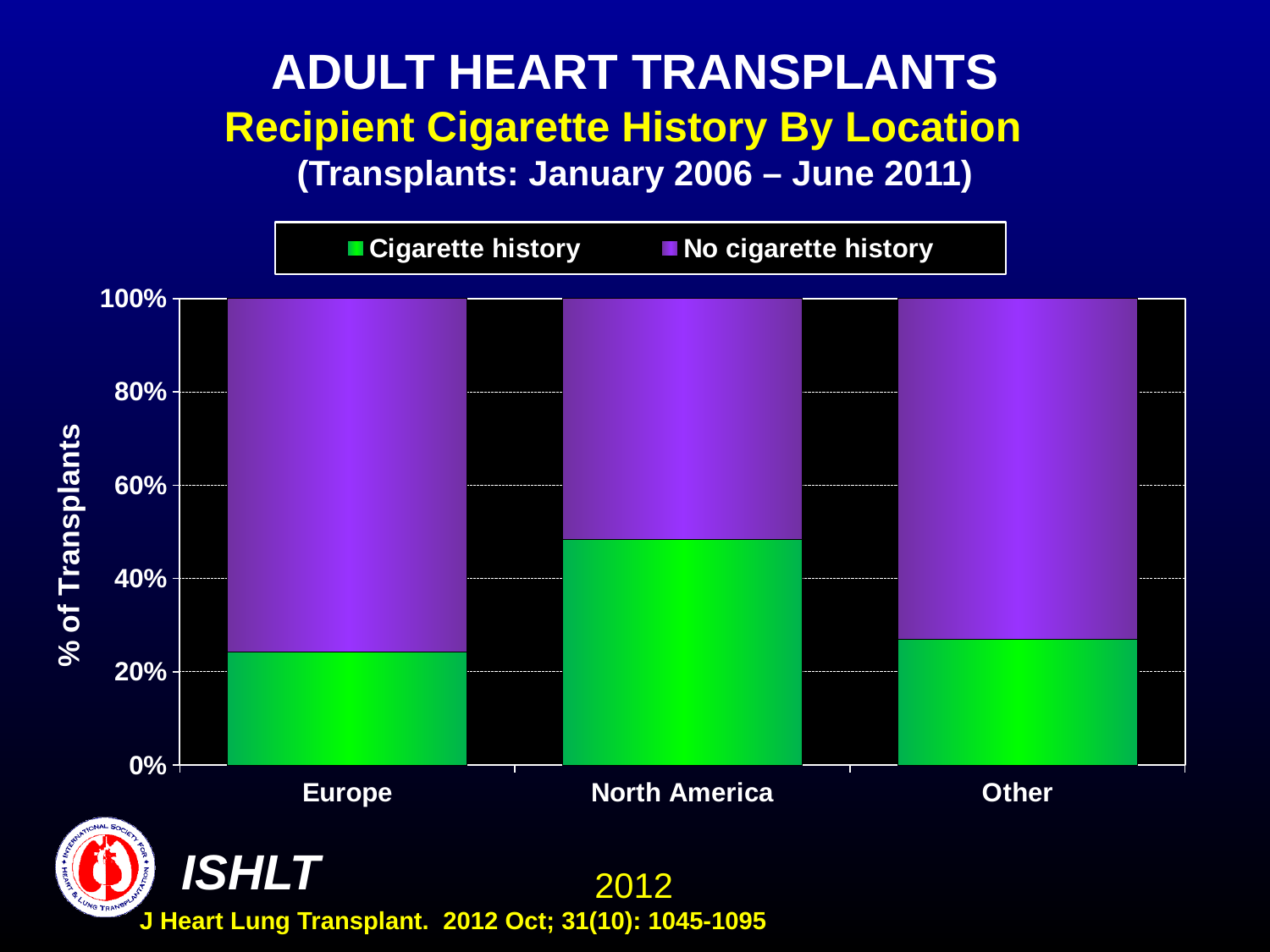
How many locations are shown on the x axis of the chart? 3 What kind of chart is shown on the slide? stacked bar chart Which location has the highest share of recipients with no cigarette history? Europe What is the total height of each stacked bar in the chart? 100% Is the cigarette history share for North America greater or less than 60%? less Is the cigarette history share for North America greater or less than 40%? greater Which colour represents 'No cigarette history' in the chart? purple Is the cigarette history share for Other greater or less than 20%? greater How many series does the legend list? 2 Which location has the highest share of recipients with a cigarette history? North America Which is larger: the cigarette history share for North America or for Europe? North America